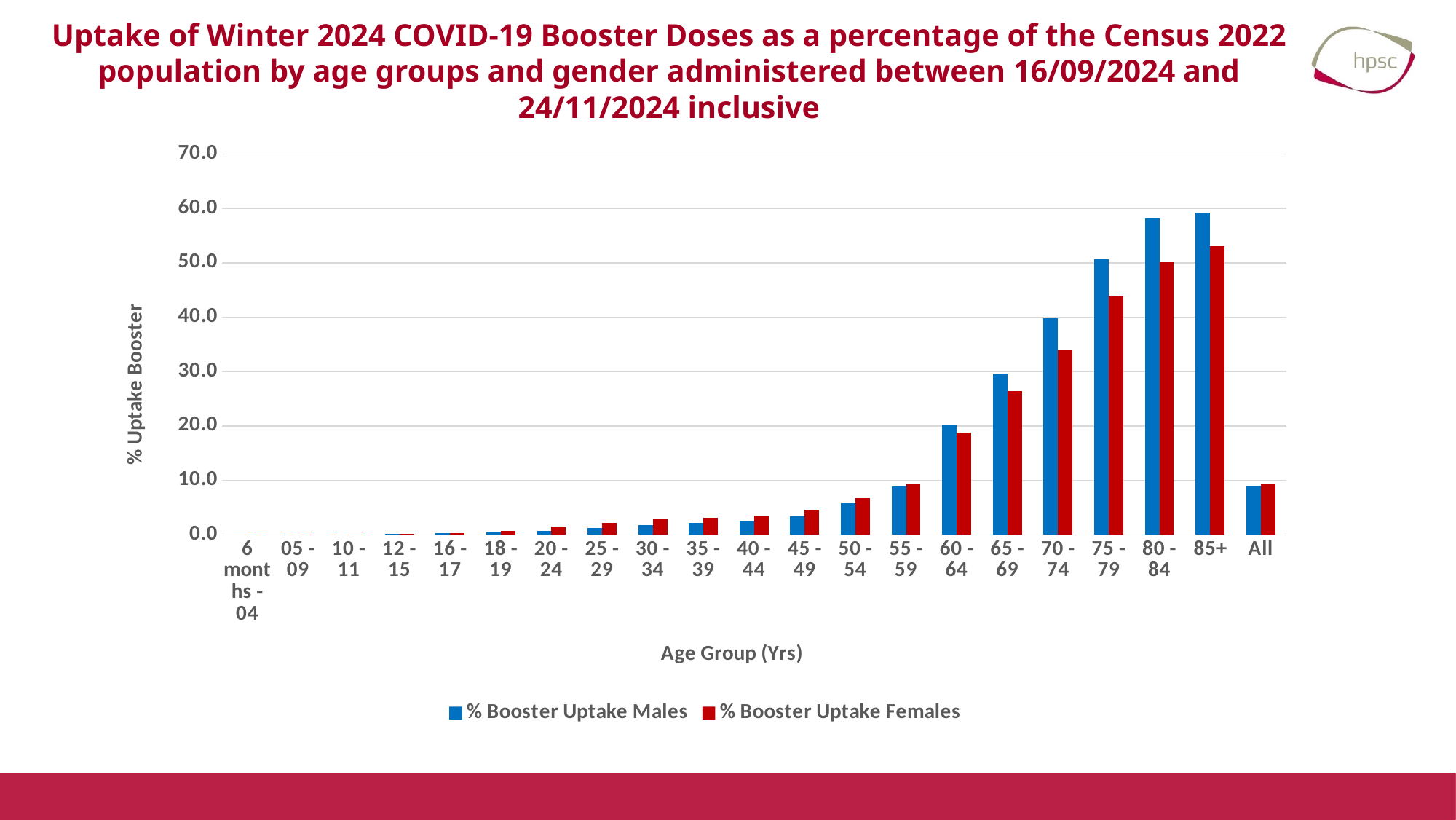
For the 45 - 49 age group, which is larger: % Booster Uptake Males or % Booster Uptake Females? % Booster Uptake Females How many series does the legend list? 2 Is the % Booster Uptake Males for the 80 - 84 age group greater or less than 60.0? less Is the % Booster Uptake Females for the 65 - 69 age group greater or less than 30.0? less Which age group has the lowest % Booster Uptake Males? 6 months - 04 What kind of chart is shown on the slide? bar chart Is the % Booster Uptake Females for the 75 - 79 age group greater or less than 40.0? greater For the 70 - 74 age group, which is larger: % Booster Uptake Males or % Booster Uptake Females? % Booster Uptake Males How many age group categories are shown on the x axis, including 'All'? 21 Which age group has the highest % Booster Uptake Females? 85+ Do the booster uptake values generally rise or fall as age increases from 6 months - 04 to 85+? rise